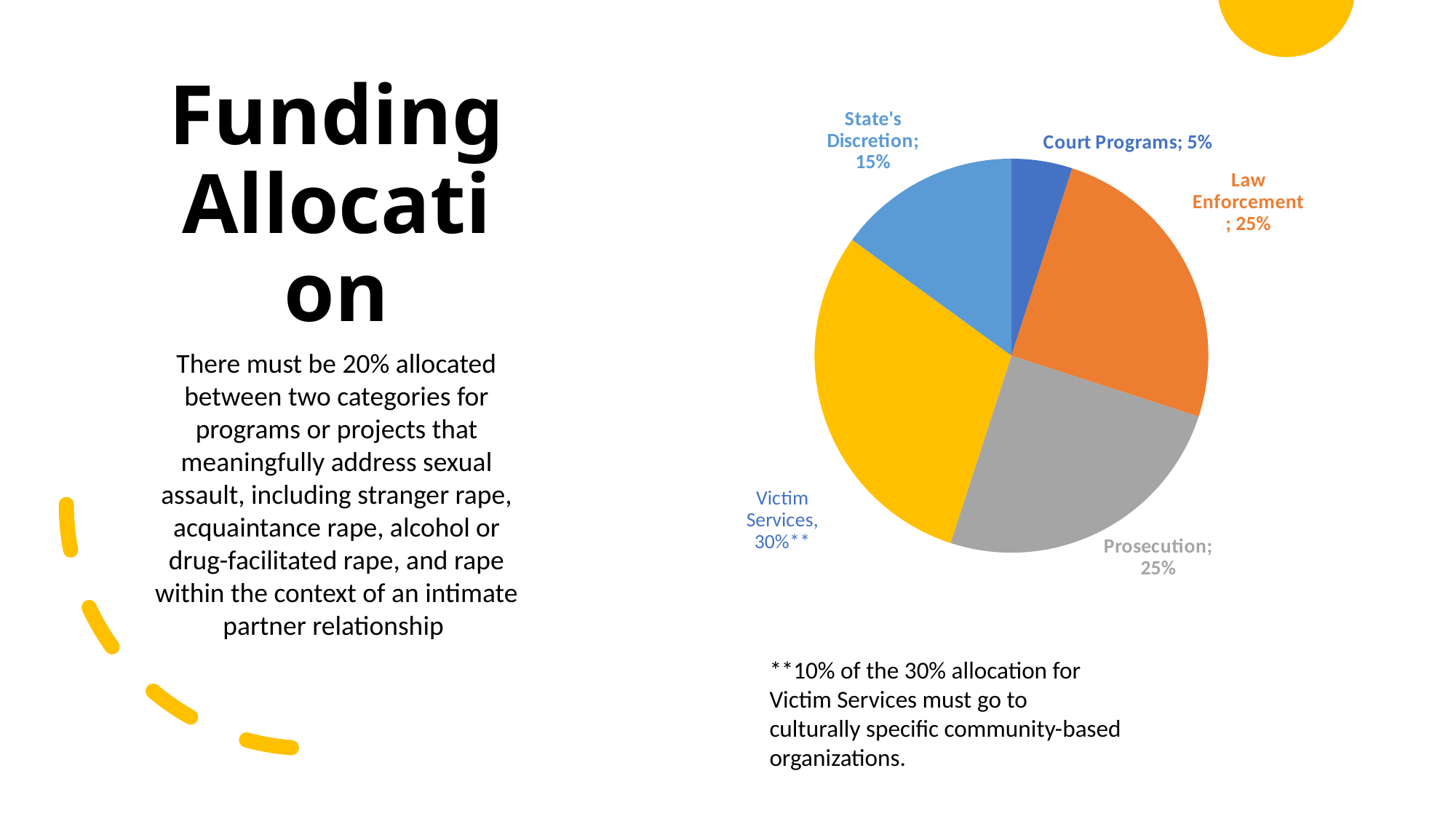
What percentage of funding is allocated to Victim Services? 30% What is the difference between the Victim Services share and the State's Discretion share? 15% Which category receives the smallest share of funding? Court Programs What colour is the Victim Services slice? yellow Which category receives the largest share of funding? Victim Services What percentage of funding is allocated to Court Programs? 5% How many categories are shown in the pie chart? 5 What percentage of funding is allocated to Law Enforcement? 25% What kind of chart is shown on the slide? pie chart What is the combined share of Law Enforcement and Prosecution? 50% What percentage of funding is allocated to State's Discretion? 15% Which is larger, the share for Prosecution or the share for Court Programs? Prosecution